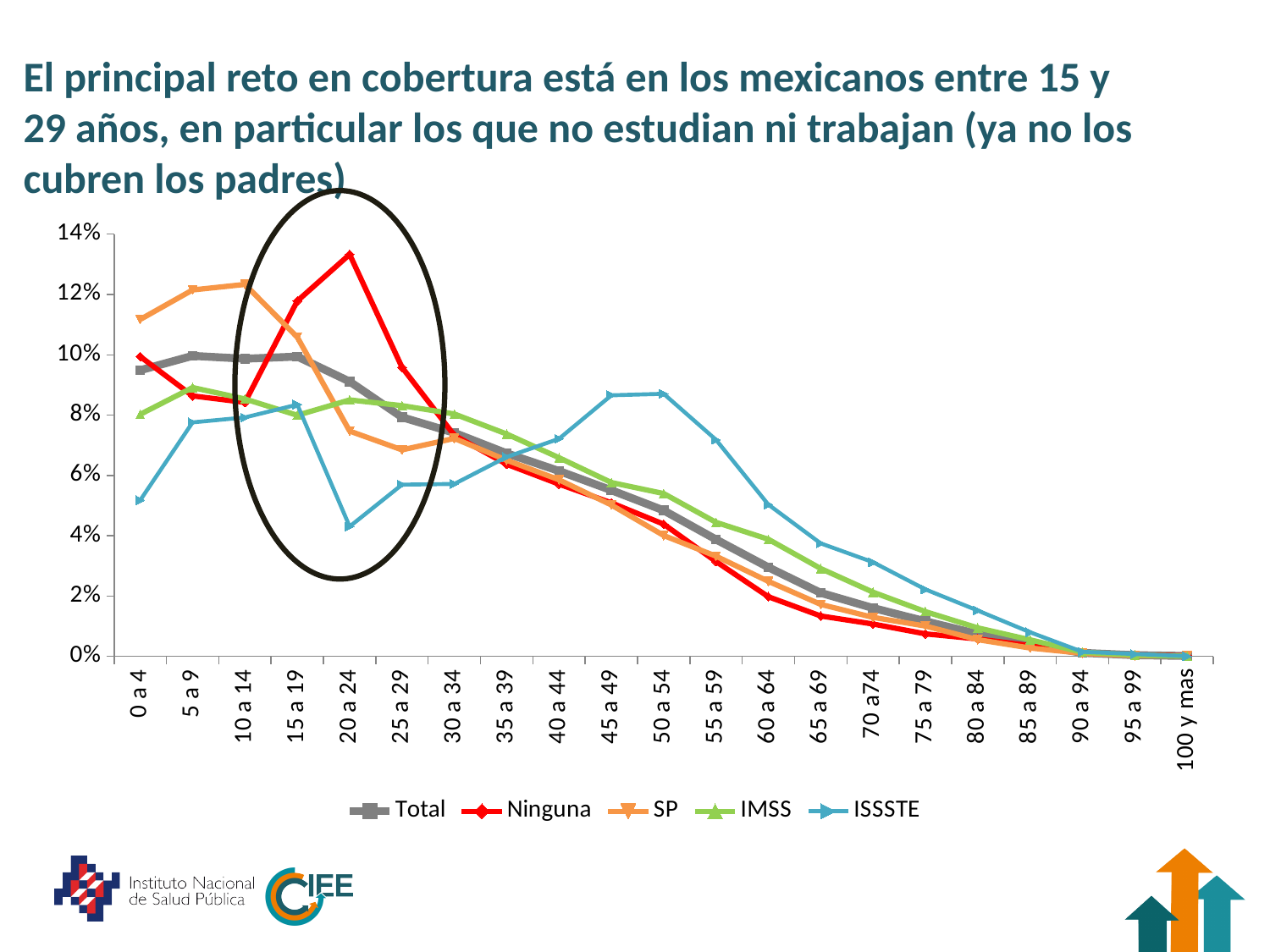
What kind of chart is shown on the slide? line chart At 0 a 4, which series has the larger value, SP or ISSSTE? SP Is the value for ISSSTE at 20 a 24 greater or less than 6%? less Does the Total series rise or fall from 20 a 24 to 100 y mas? fall Is the value for SP at 10 a 14 greater or less than 10%? greater Which series has the lowest value at 0 a 4? ISSSTE How many age-group categories are shown on the x axis? 21 Which series has the highest value at 45 a 49? ISSSTE Is the value for Ninguna at 20 a 24 greater or less than 12%? greater What colour is the Ninguna series line? red How many series does the legend list? 5 For which age group does the Ninguna series reach its highest value? 20 a 24